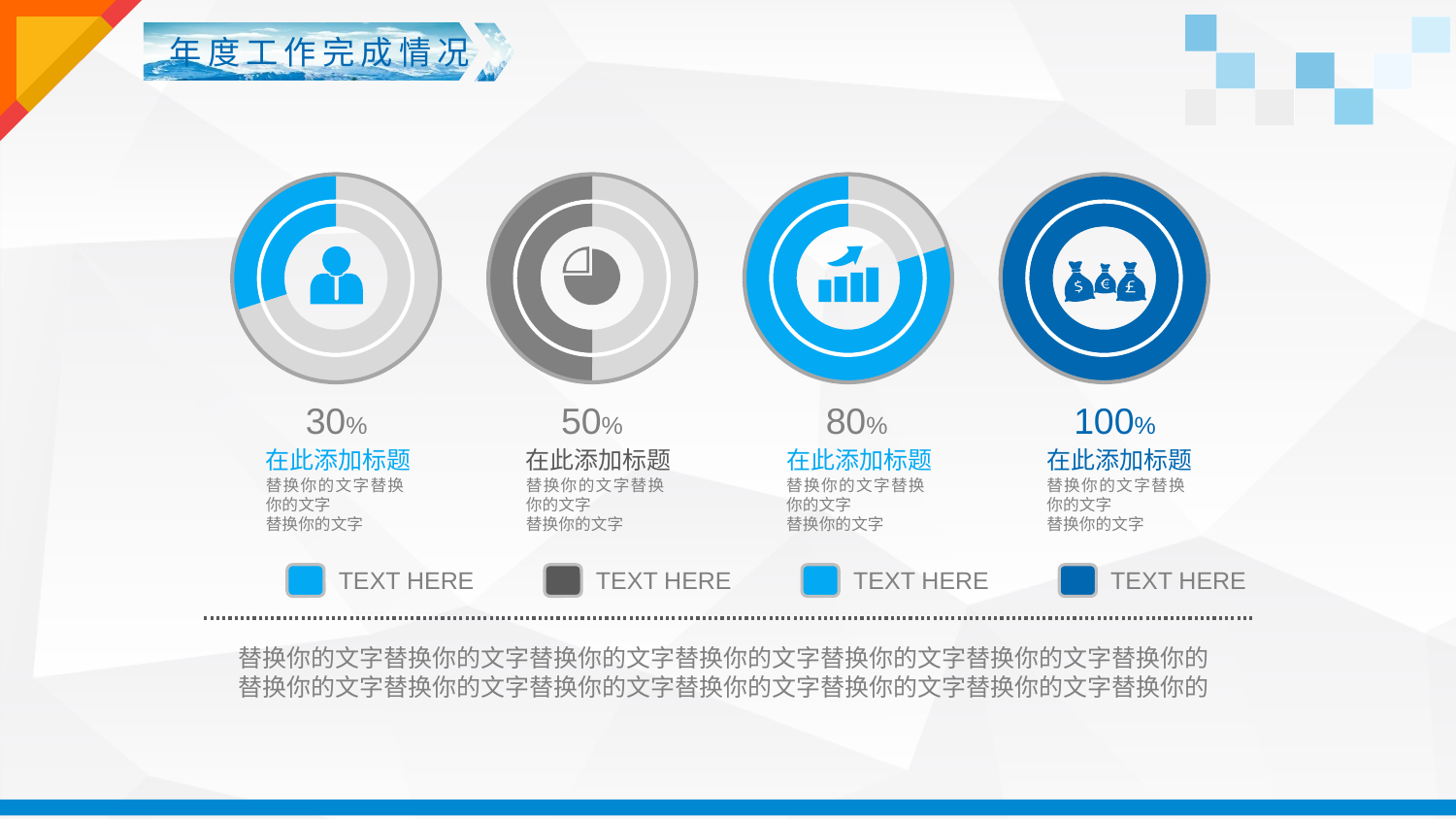
Which is larger, the percentage of the second donut chart or the third donut chart? The third donut chart (80%) What percentage is shown below the second donut chart with the pie-chart icon? 50% Which of the four donut charts shows the highest percentage? The fourth (rightmost) chart, 100% Do the percentages rise or fall from the leftmost chart to the rightmost chart? Rise What percentage is shown below the first (leftmost) donut chart with the person icon? 30% What kind of chart is used to display the percentages on this slide? Donut chart What percentage is shown below the third donut chart with the rising bar-chart icon? 80% What percentage is shown below the fourth (rightmost) donut chart with the money-bag icon? 100% Which of the four donut charts shows the lowest percentage? The first (leftmost) chart, 30% What colour is the filled ring of the second donut chart (50%)? Gray How many donut charts are shown on the slide? 4 What is the difference between the percentage of the third donut chart and the first donut chart? 50 percentage points